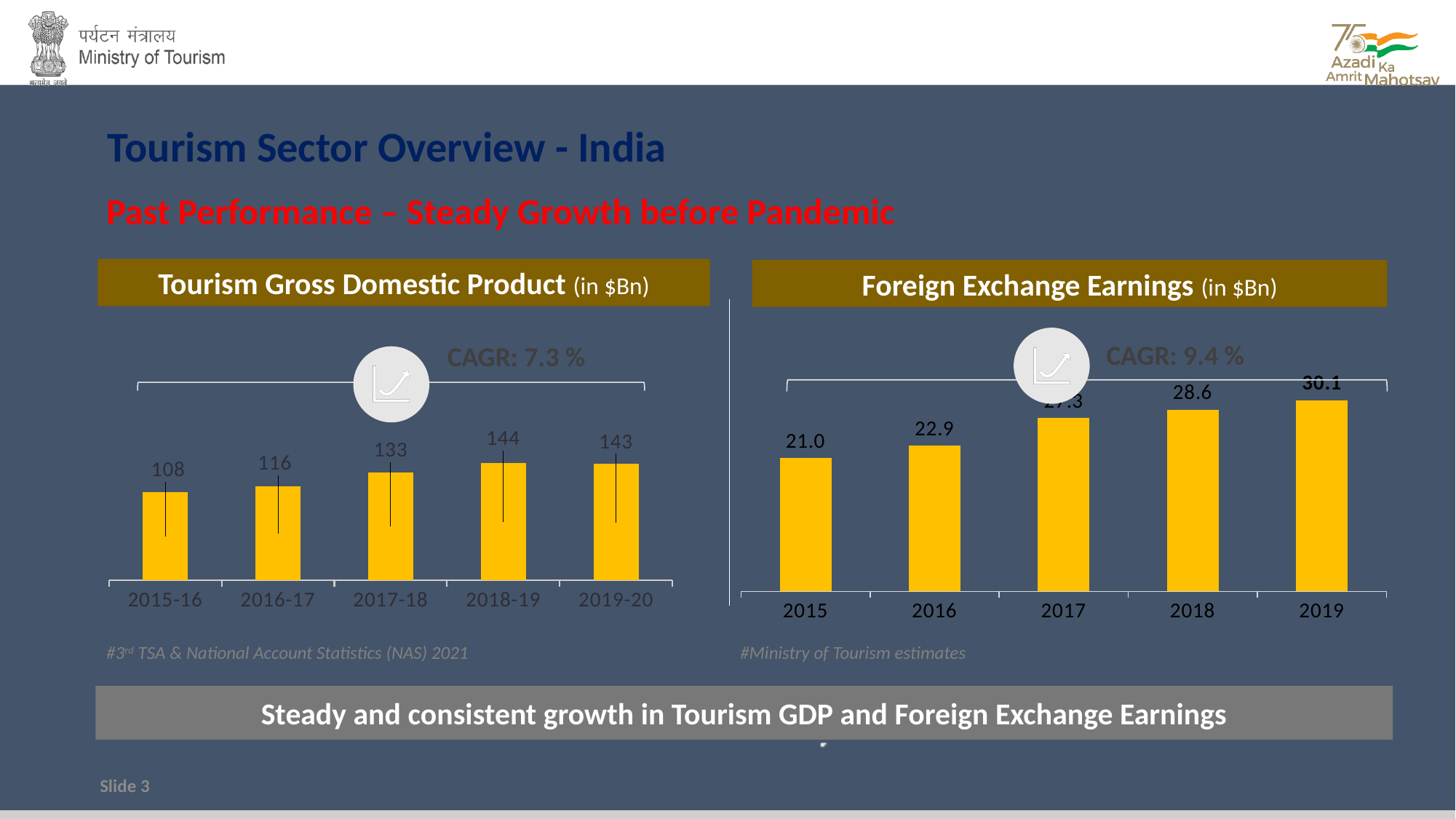
In the Tourism Gross Domestic Product chart, how many years are shown on the x axis? 5 What kind of chart is the Foreign Exchange Earnings chart? bar chart In the Foreign Exchange Earnings chart, do the values rise or fall from 2015 to 2019? rise In the Tourism Gross Domestic Product chart, which year has the highest value? 2018-19 In the Tourism Gross Domestic Product chart, which year has the lowest value? 2015-16 In the Tourism Gross Domestic Product chart, what is the difference between the values for 2017-18 and 2016-17? 17 In the Tourism Gross Domestic Product chart, what is the value for 2015-16? 108 In the Foreign Exchange Earnings chart, what is the value for 2018? 28.6 In the Foreign Exchange Earnings chart, what is the value for 2016? 22.9 In the Tourism Gross Domestic Product chart, what is the value for 2018-19? 144 In the Foreign Exchange Earnings chart, what is the difference between the values for 2019 and 2015? 9.1 In the Foreign Exchange Earnings chart, which year has the highest value? 2019